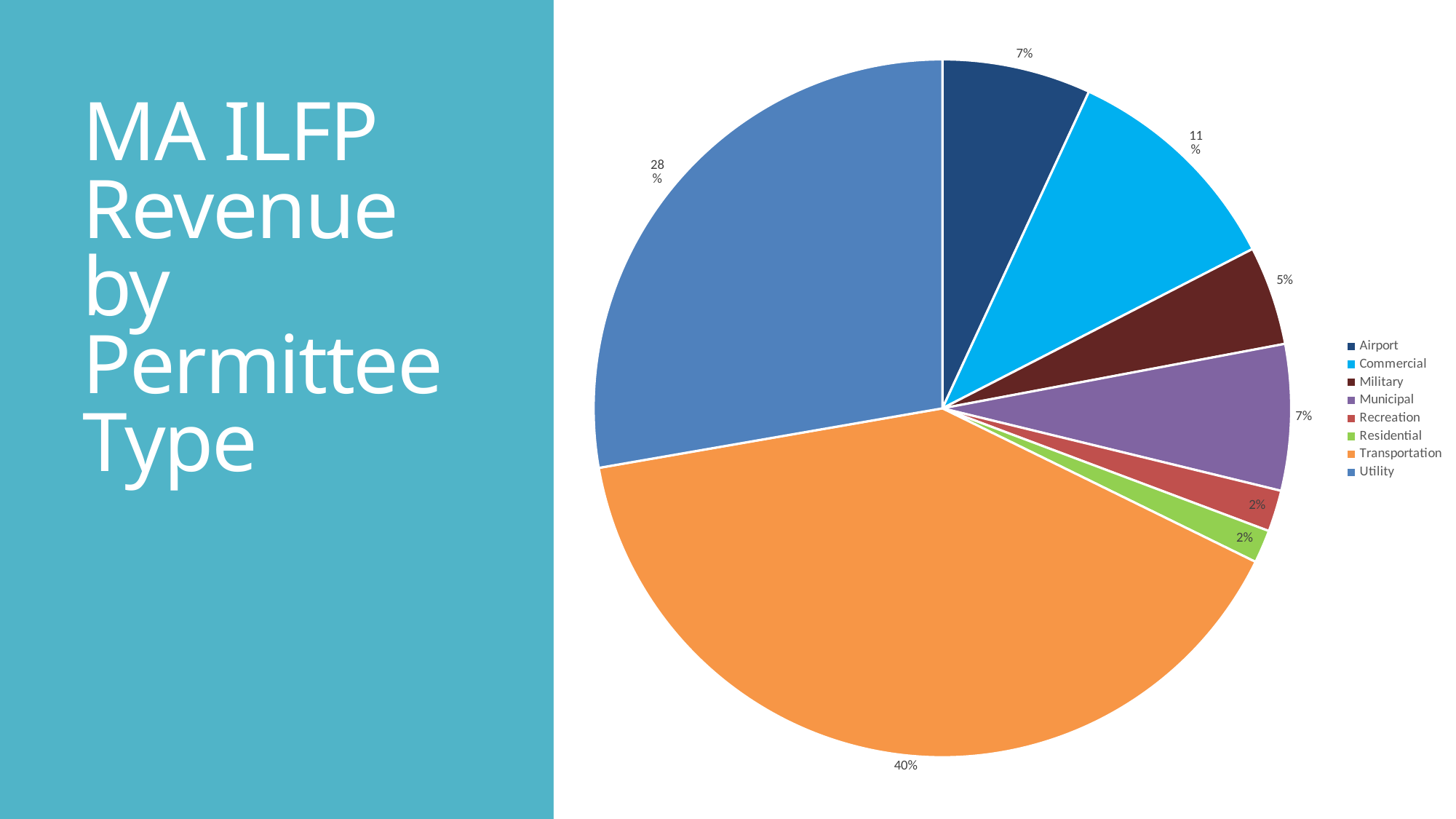
What share of revenue does Utility account for? 28% What is the difference in percentage points between the Transportation and Utility shares? 12 How many permittee types are listed in the legend? 8 Which permittee type has the largest share of revenue? Transportation What share of revenue does Airport account for? 7% What share of revenue does Military account for? 5% What is the title of the slide? MA ILFP Revenue by Permittee Type What share of revenue does Transportation account for? 40% What is the combined share of Transportation and Utility? 68% What share of revenue does Commercial account for? 11% What kind of chart is shown on the slide? pie chart Which permittee type has a larger share, Utility or Commercial? Utility